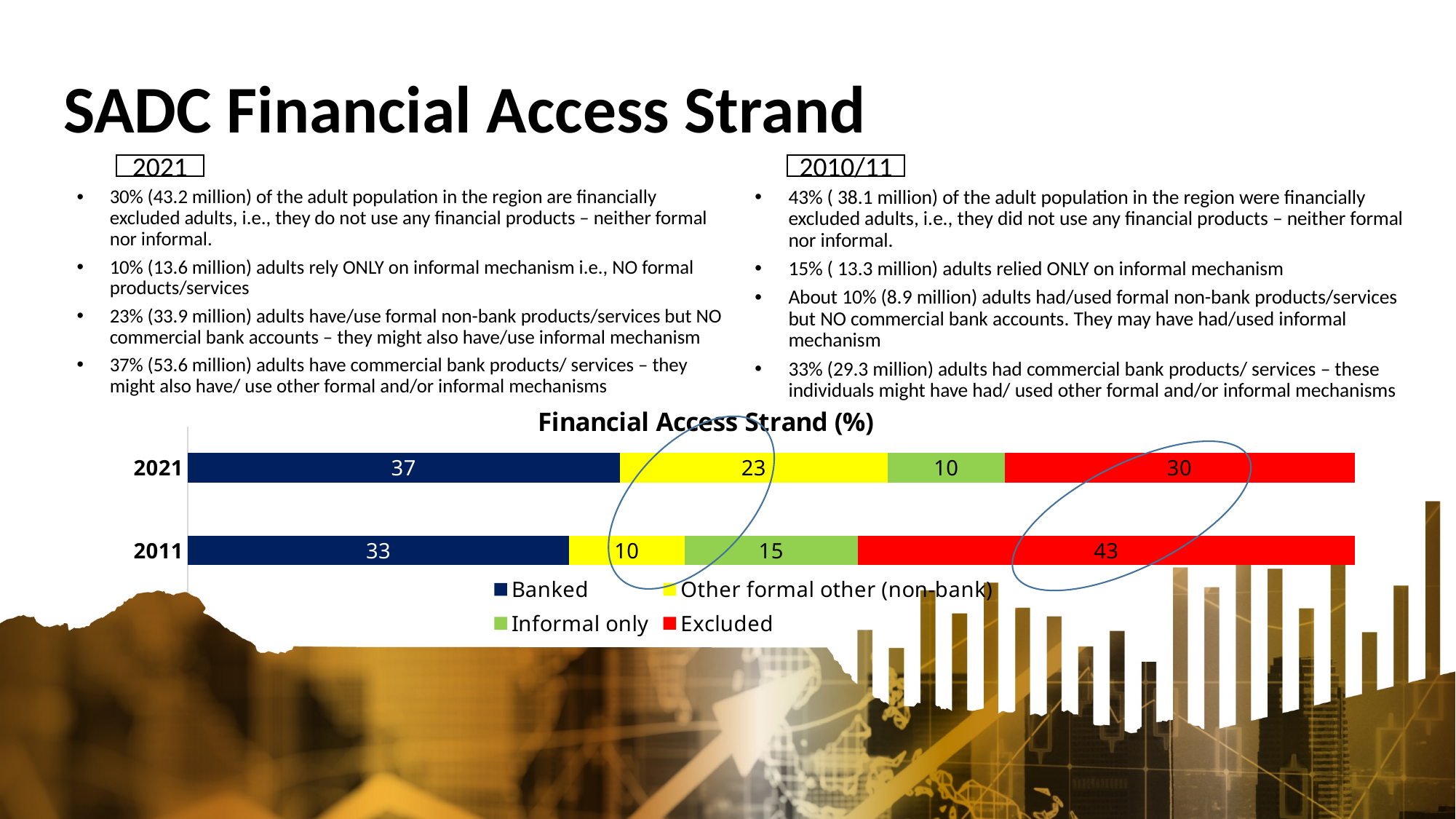
What kind of chart is shown on the slide? Stacked bar chart What is the Banked value for 2021 in the Financial Access Strand chart? 37 What is the title of the chart? Financial Access Strand (%) What is the total of the stacked bar for 2021? 100 Which year has the higher Banked value? 2021 What is the difference between the Excluded values for 2011 and 2021? 13 What is the Excluded value for 2011 in the Financial Access Strand chart? 43 What is the Informal only value for 2021? 10 Which year has the higher Excluded value? 2011 What is the Other formal other (non-bank) value for 2011? 10 How many series does the legend list? 4 What is the difference between the Other formal other (non-bank) values for 2021 and 2011? 13